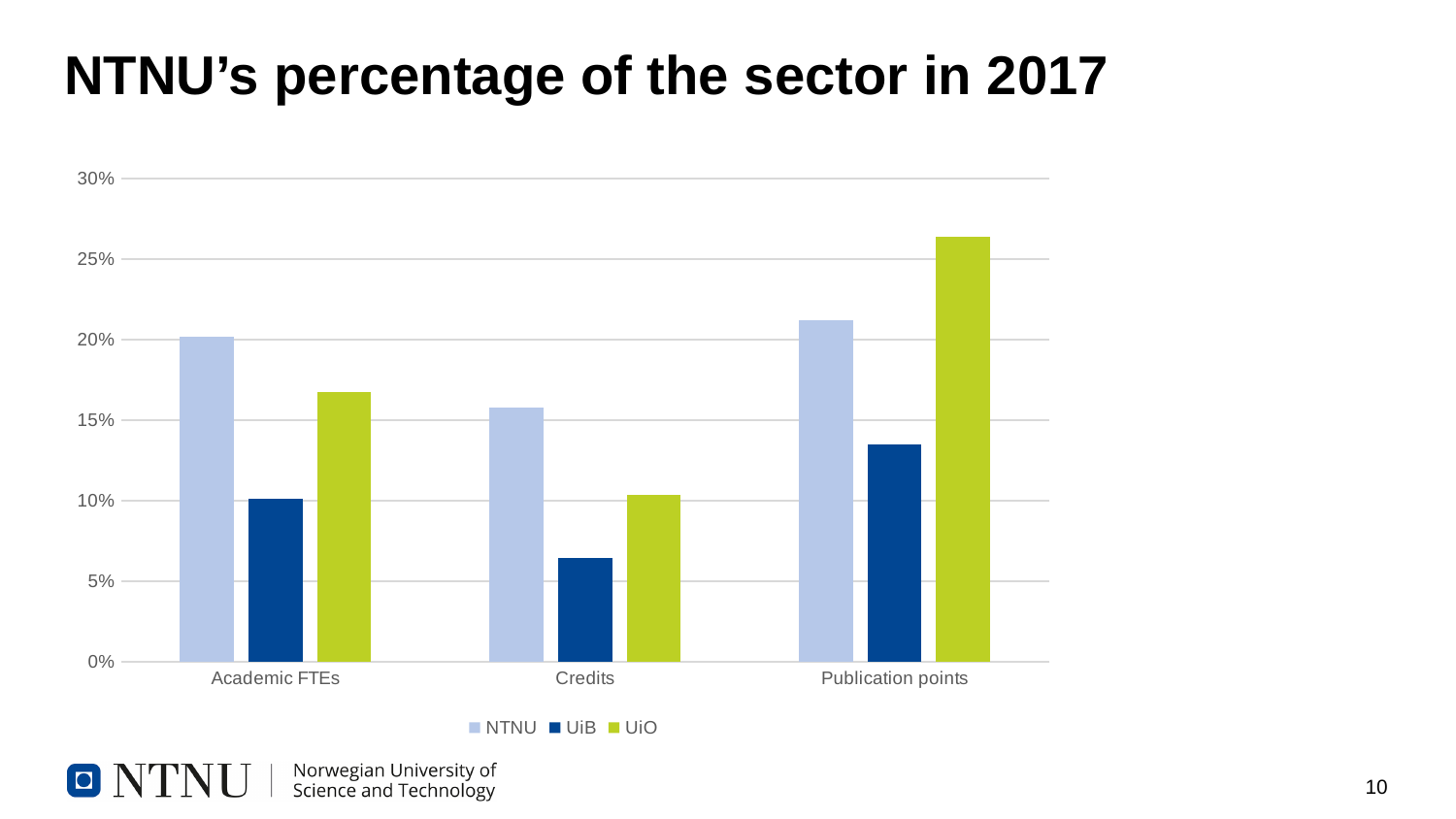
Which series has the lowest value for Credits? UiB Is the value for UiO in Publication points greater or less than 25%? greater Which series has the highest value for Publication points? UiO Which series has the highest value for Academic FTEs? NTNU Is the value for UiB in Credits greater or less than 10%? less Which series is shown in dark blue in the legend? UiB Is the value for UiO in Academic FTEs greater or less than 15%? greater How many series does the legend list? 3 Which is larger for UiO: the value for Academic FTEs or the value for Credits? Academic FTEs What is the title of the chart? NTNU's percentage of the sector in 2017 How many categories are shown on the x axis? 3 What kind of chart is shown on the slide? bar chart